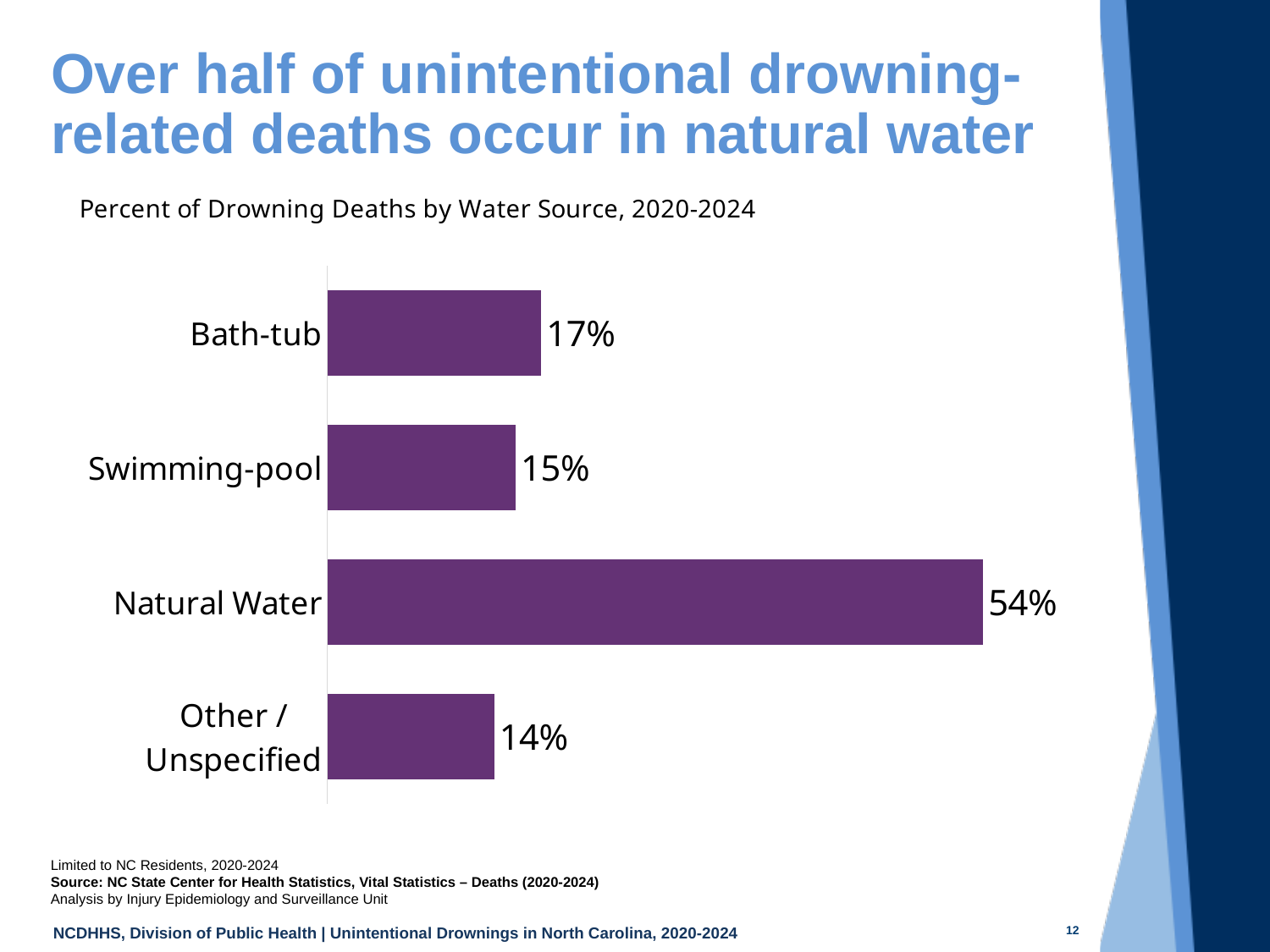
What percent of drowning deaths are in the Other / Unspecified category? 14% What percent of drowning deaths occurred in a bath-tub? 17% What type of chart is shown on the slide? Bar chart Which water source has the lowest percent of drowning deaths? Other / Unspecified What is the difference in percentage points between Natural Water and Bath-tub? 37 How many water source categories are shown in the chart? 4 What percent of drowning deaths occurred in a swimming-pool? 15% Which water source has the highest percent of drowning deaths? Natural Water Which has a higher percent of drowning deaths, Bath-tub or Swimming-pool? Bath-tub What is the title of the chart? Percent of Drowning Deaths by Water Source, 2020-2024 What is the difference in percentage points between Bath-tub and Swimming-pool? 2 What percent of drowning deaths occurred in natural water? 54%